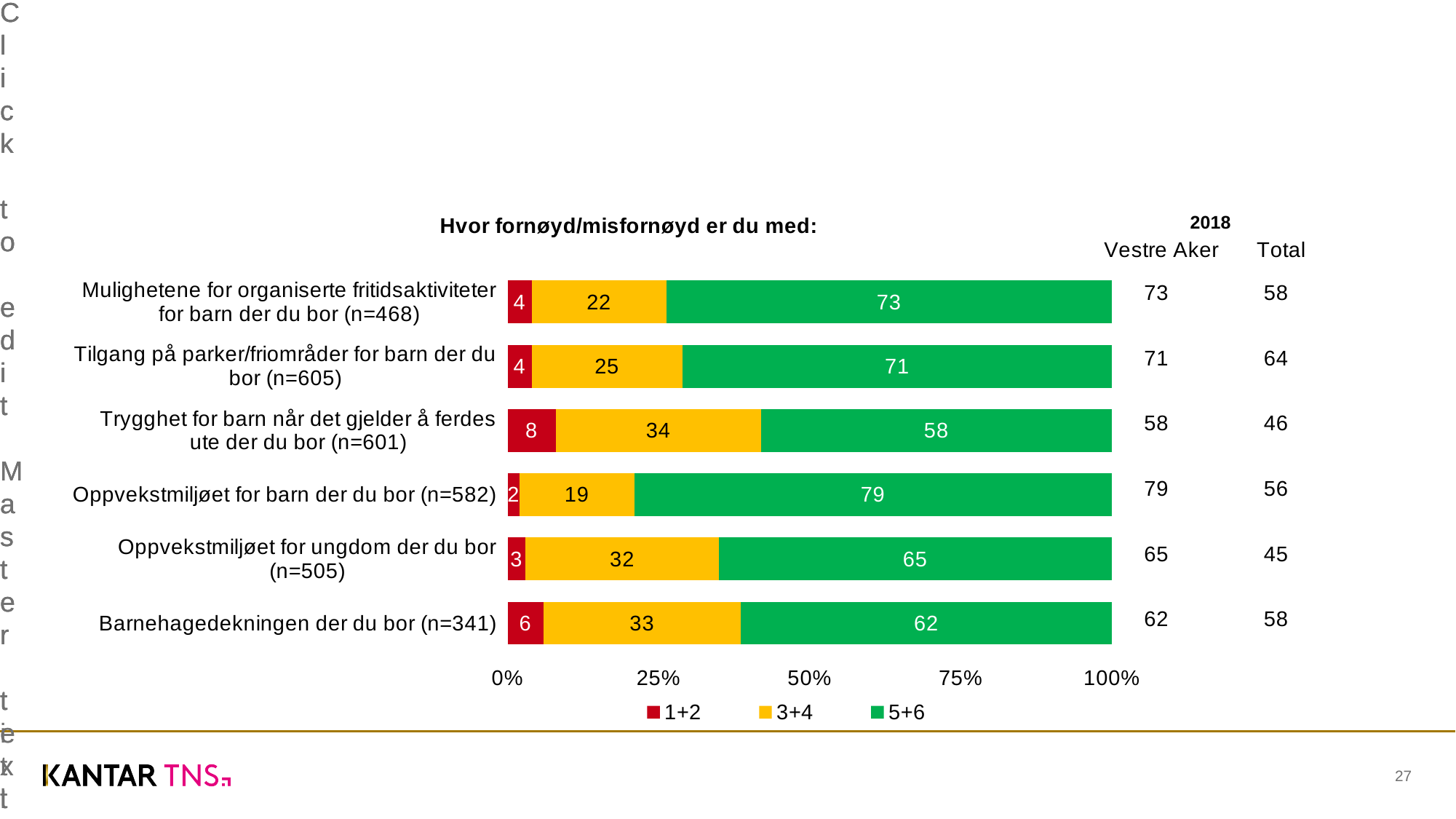
What is the value of the 3+4 segment for "Barnehagedekningen der du bor (n=341)"? 33 How many categories are shown in the chart? 6 Which category has the highest 5+6 value? Oppvekstmiljøet for barn der du bor (n=582) What is the title of the chart? Hvor fornøyd/misfornøyd er du med: What is the difference between the 5+6 values for "Mulighetene for organiserte fritidsaktiviteter for barn der du bor (n=468)" and "Tilgang på parker/friområder for barn der du bor (n=605)"? 2 Which category has the lowest 5+6 value? Trygghet for barn når det gjelder å ferdes ute der du bor (n=601) How many series does the legend list? 3 What is the value of the 5+6 segment for "Oppvekstmiljøet for barn der du bor (n=582)"? 79 What is the total of the stacked bar for "Tilgang på parker/friområder for barn der du bor (n=605)"? 100 Which has the larger 1+2 value: "Trygghet for barn når det gjelder å ferdes ute der du bor (n=601)" or "Barnehagedekningen der du bor (n=341)"? Trygghet for barn når det gjelder å ferdes ute der du bor (n=601) What kind of chart is shown on the slide? Stacked bar chart What is the value of the 1+2 segment for "Trygghet for barn når det gjelder å ferdes ute der du bor (n=601)"? 8